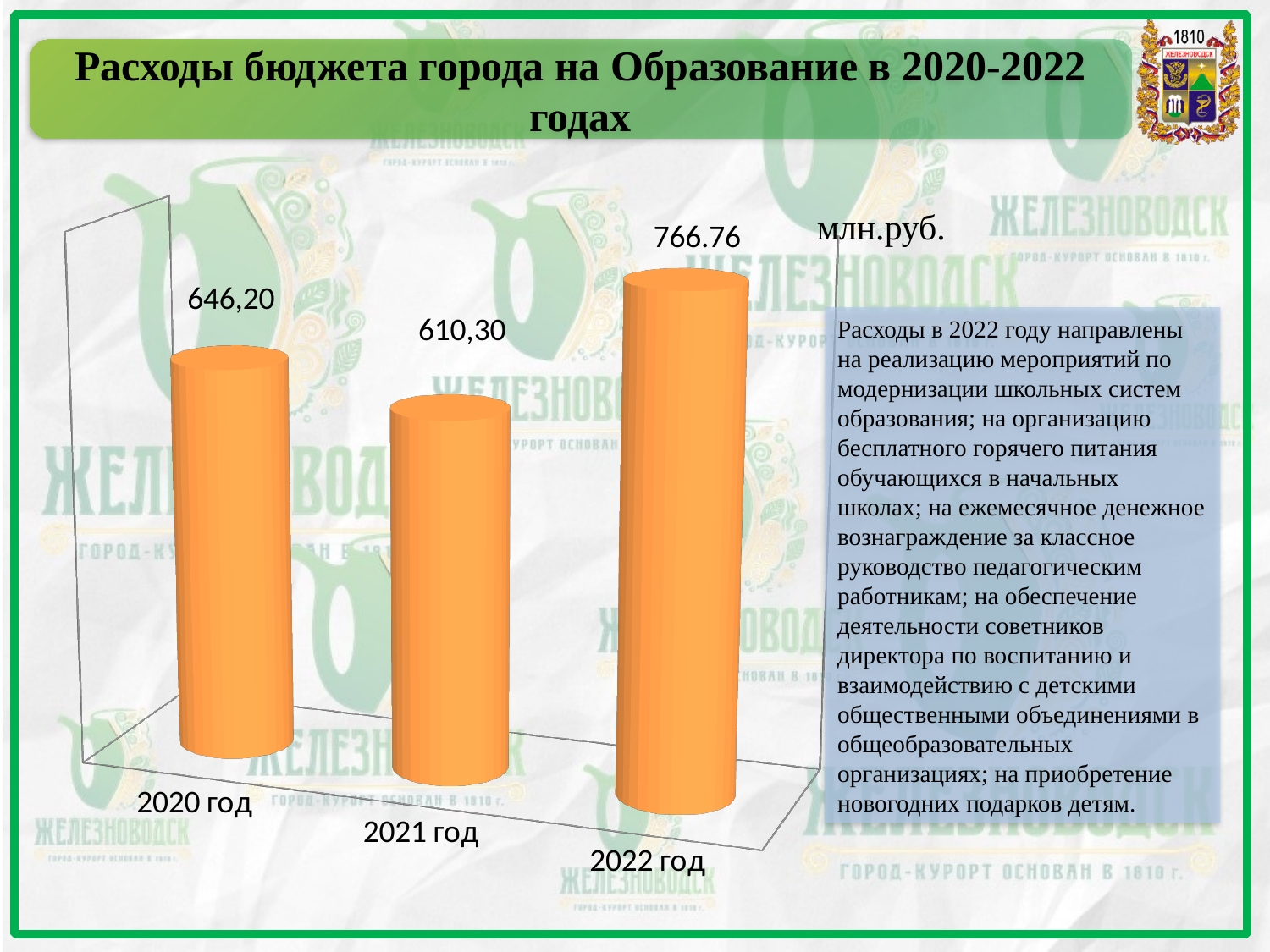
What is the value for 2021 год? 610,30 What is the value for 2020 год? 646,20 What unit of measurement is indicated for the chart values? млн.руб. How many categories are shown in the chart? 3 What kind of chart is shown on the slide? bar chart What is the value for 2022 год? 766.76 Which is larger, the value for 2022 год or the value for 2020 год? 2022 год Which year has the highest value? 2022 год Which year has the lowest value? 2021 год Do the values rise or fall from 2021 год to 2022 год? rise Which is larger, the value for 2020 год or the value for 2021 год? 2020 год What is the difference between the values for 2020 год and 2021 год? 35,90